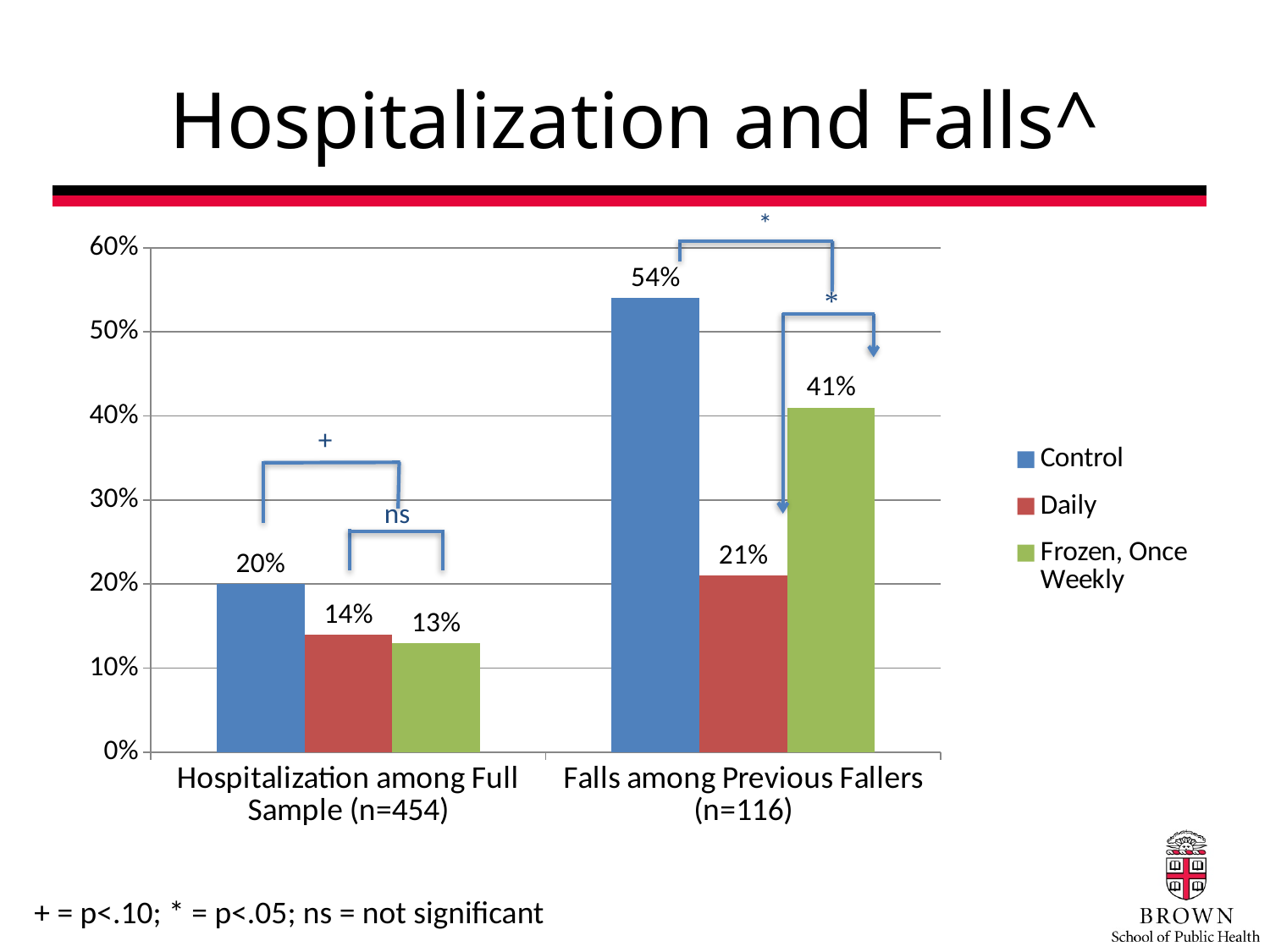
What is the Control value for Hospitalization among Full Sample (n=454)? 20% What kind of chart is shown on the slide? Bar chart What is the Frozen, Once Weekly value for Hospitalization among Full Sample (n=454)? 13% What is the difference between the Control and Daily values for Falls among Previous Fallers (n=116)? 33% What is the difference between the Control and Daily values for Hospitalization among Full Sample (n=454)? 6% Which series has the highest value for Falls among Previous Fallers (n=116)? Control What colour represents the Daily series in the chart? Red What is the Frozen, Once Weekly value for Falls among Previous Fallers (n=116)? 41% What is the Daily value for Falls among Previous Fallers (n=116)? 21% How many series does the legend list? 3 Which series has the lowest value for Hospitalization among Full Sample (n=454)? Frozen, Once Weekly Which is larger: the Frozen, Once Weekly value for Falls among Previous Fallers or the Control value for Hospitalization among Full Sample? Frozen, Once Weekly value for Falls among Previous Fallers